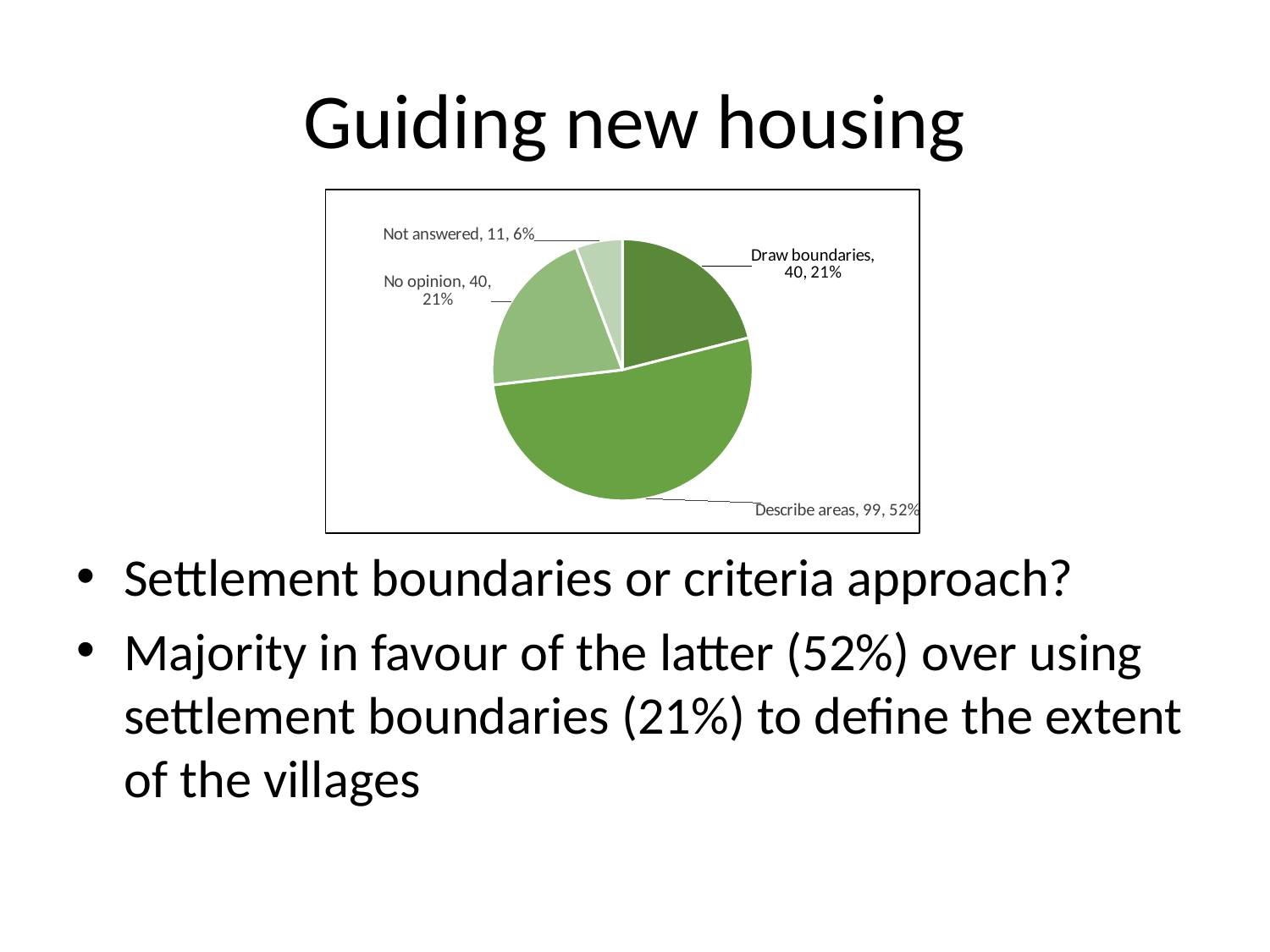
What is the value for Draw boundaries? 40 How many slices does the pie chart have? 4 What is the value for Describe areas? 99 Which category has the smallest slice? Not answered What kind of chart is shown on the slide? pie chart What is the total of all the slice values in the pie chart? 190 What share of the pie does No opinion represent? 21% Which category has the largest slice? Describe areas Which is larger, the value for No opinion or the value for Not answered? No opinion What is the difference between the values for Describe areas and Draw boundaries? 59 What share of the pie does Describe areas represent? 52% What is the value for Not answered? 11